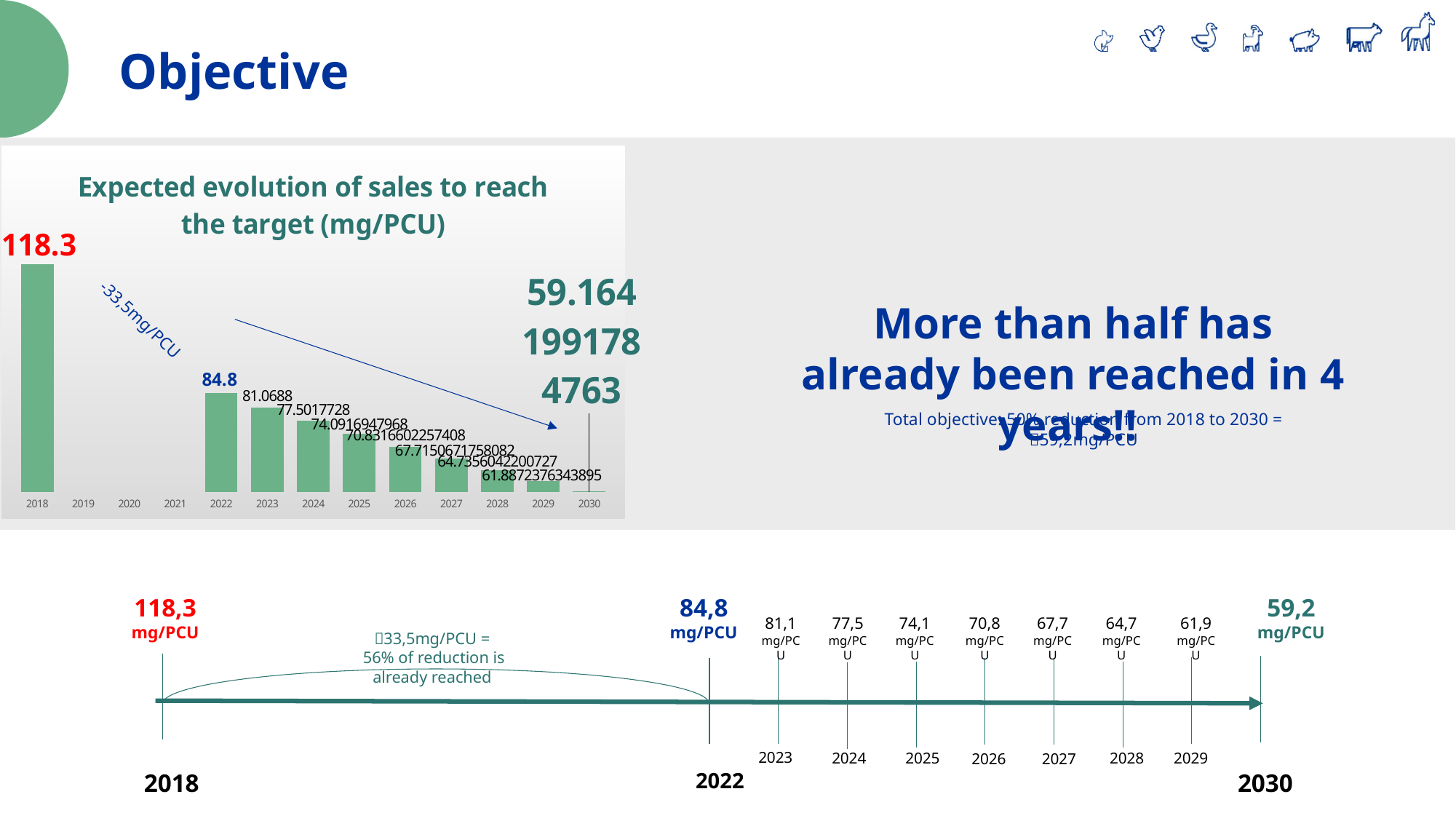
What is the value for 2026 in the chart? 70.8316602257408 What is the difference between the values for 2018 and 2022? 33.5 What kind of chart is shown on the slide? bar chart Which year has the lowest value in the chart? 2030 What is the title of the chart? Expected evolution of sales to reach the target (mg/PCU) Which year has the highest value in the chart? 2018 What is the value for 2018 in the chart? 118.3 Which is larger, the value for 2025 or the value for 2027? 2025 Do the values rise or fall from 2022 to 2030 along the x axis? fall What is the value for 2024 in the chart? 77.5017728 What is the value for 2022 in the chart? 84.8 What is the value for 2023 in the chart? 81.0688